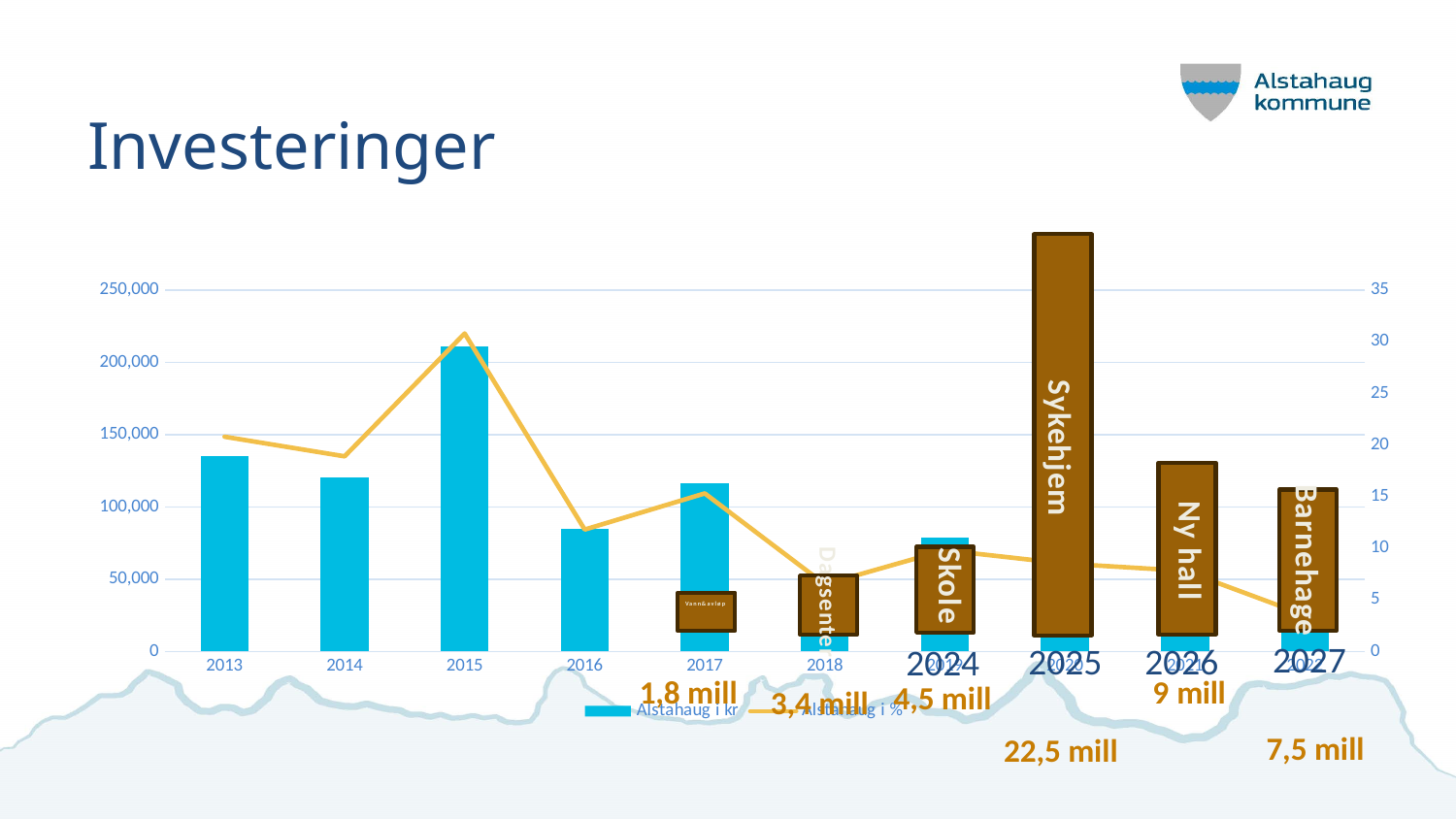
Which series is drawn as a line in the chart? Alstahaug i % Is the blue bar for 2016 greater or less than 100,000? less Which blue bar is taller, 2015 or 2016? 2015 What kind of chart is shown on the slide? Combined bar and line chart Which blue bar is taller, 2013 or 2014? 2013 Is the blue bar for 2013 greater or less than 100,000? greater Which year has the tallest blue bar (Alstahaug i kr)? 2015 What is the title of the slide containing the chart? Investeringer Is the blue bar for 2015 greater or less than 150,000? greater How many series does the legend list? 2 Do the blue bars rise or fall from 2015 to 2018? fall